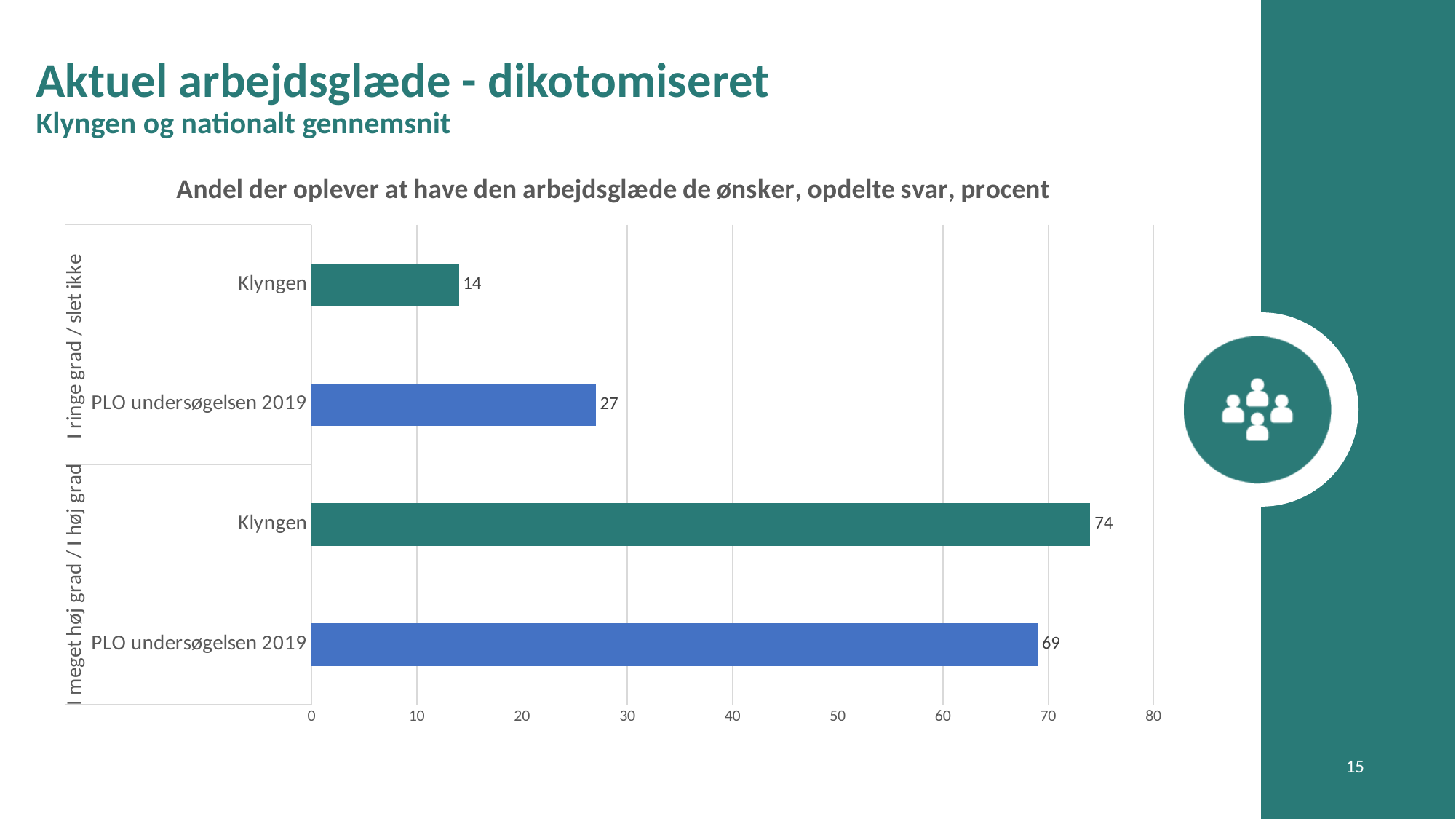
What is the difference between Klyngen and PLO undersøgelsen 2019 in the 'I meget høj grad / I høj grad' group? 5 What type of chart is shown on the slide? Bar chart What is the difference between PLO undersøgelsen 2019 and Klyngen in the 'I ringe grad / slet ikke' group? 13 What is the value for PLO undersøgelsen 2019 in the 'I meget høj grad / I høj grad' group? 69 How many bars are plotted in the chart? 4 Is the value for Klyngen in the 'I meget høj grad / I høj grad' group greater or less than 70? greater What is the value for PLO undersøgelsen 2019 in the 'I ringe grad / slet ikke' group? 27 What is the value for Klyngen in the 'I meget høj grad / I høj grad' group? 74 What is the value for Klyngen in the 'I ringe grad / slet ikke' group? 14 Which bar has the highest value in the chart? Klyngen (I meget høj grad / I høj grad) Which bar has the lowest value in the chart? Klyngen (I ringe grad / slet ikke) In the 'I ringe grad / slet ikke' group, which is larger: Klyngen or PLO undersøgelsen 2019? PLO undersøgelsen 2019